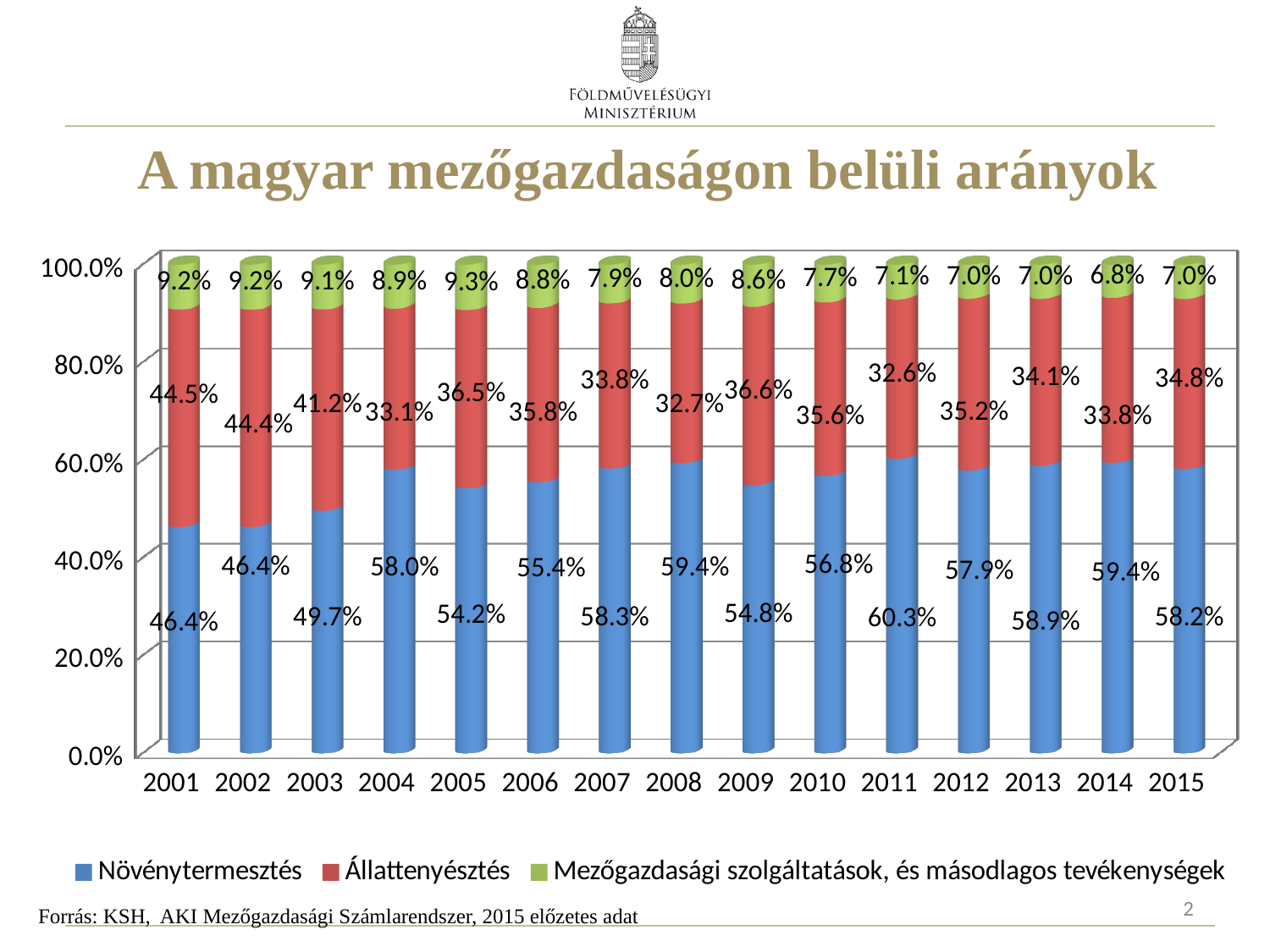
How many years are shown on the x axis? 15 Which is larger: the Állattenyésztés value in 2001 or in 2015? 2001 In which year is the Növénytermesztés share highest? 2011 How many series does the legend list? 3 What is the difference between the Növénytermesztés and Állattenyésztés values in 2011? 27.7 percentage points What is the value for Növénytermesztés in 2011? 60.3% In which year is the Mezőgazdasági szolgáltatások, és másodlagos tevékenységek share highest? 2005 Does the Mezőgazdasági szolgáltatások, és másodlagos tevékenységek share generally rise or fall from 2001 to 2015? Fall What is the value for Állattenyésztés in 2004? 33.1% In which year is the Állattenyésztés share lowest? 2011 What type of chart is shown on the slide? Stacked bar chart What is the value for Mezőgazdasági szolgáltatások, és másodlagos tevékenységek in 2014? 6.8%